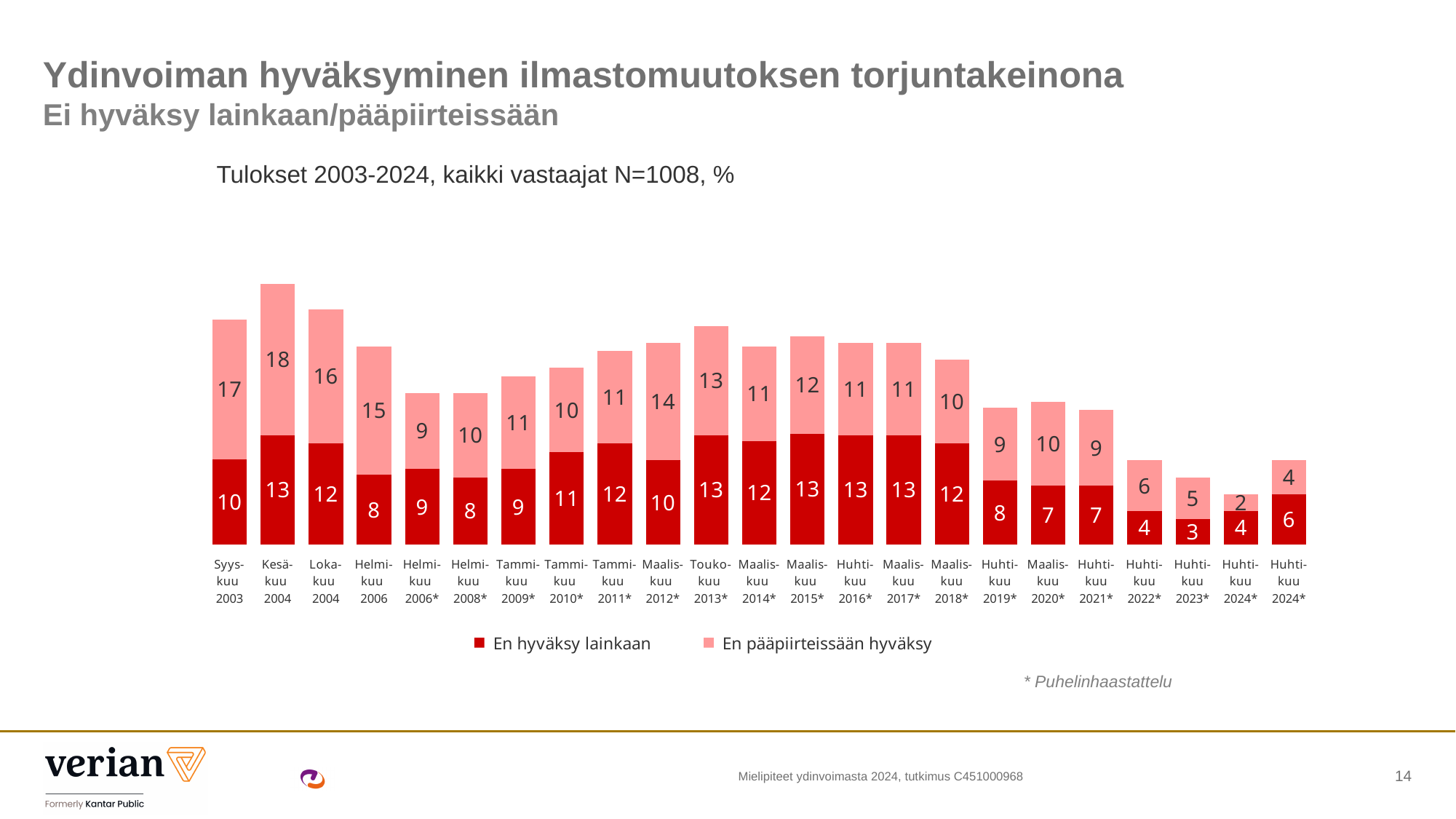
Which is larger for "En pääpiirteissään hyväksy": Maaliskuu 2012* or Toukokuu 2013*? Maaliskuu 2012* What is the value of "En pääpiirteissään hyväksy" for Maaliskuu 2012*? 14 What is the total of the stacked bar for Huhtikuu 2022*? 10 What kind of chart is shown on the slide? Stacked bar chart Does the "En hyväksy lainkaan" value rise or fall from Maaliskuu 2017* to Huhtikuu 2023*? Fall Which category has the lowest value for "En hyväksy lainkaan"? Huhtikuu 2023* How many bars (time points) are shown in the chart? 23 Which category has the highest value for "En pääpiirteissään hyväksy"? Kesäkuu 2004 What is the value of "En hyväksy lainkaan" for Syyskuu 2003? 10 How many series does the legend list? 2 What is the difference between the "En hyväksy lainkaan" values for Toukokuu 2013* and Huhtikuu 2019*? 5 What is the total of the stacked bar for Kesäkuu 2004? 31